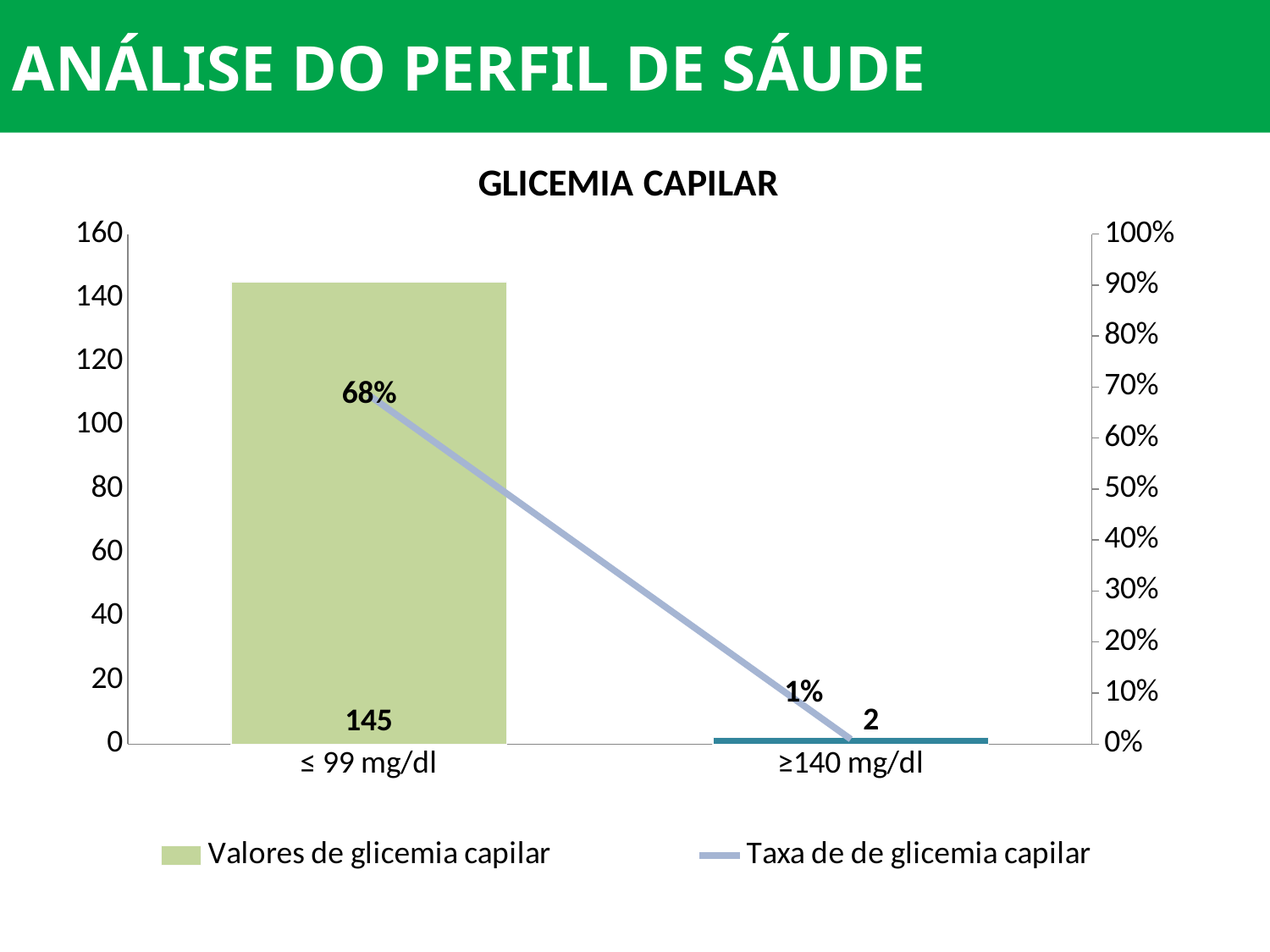
Which category has the lowest Taxa de de glicemia capilar? ≥140 mg/dl How many categories are shown on the x axis of the chart? 2 How many series does the legend list? 2 Which category has the highest value of Valores de glicemia capilar? ≤ 99 mg/dl What is the Taxa de de glicemia capilar for the ≤ 99 mg/dl category? 68% What is the difference between the Valores de glicemia capilar for ≤ 99 mg/dl and ≥140 mg/dl? 143 What is the title of the chart? GLICEMIA CAPILAR What is the value of Valores de glicemia capilar for the ≥140 mg/dl category? 2 What is the value of Valores de glicemia capilar for the ≤ 99 mg/dl category? 145 Does the Taxa de de glicemia capilar line rise or fall from ≤ 99 mg/dl to ≥140 mg/dl? fall What is the Taxa de de glicemia capilar for the ≥140 mg/dl category? 1% Which is larger, the Valores de glicemia capilar for ≤ 99 mg/dl or for ≥140 mg/dl? ≤ 99 mg/dl